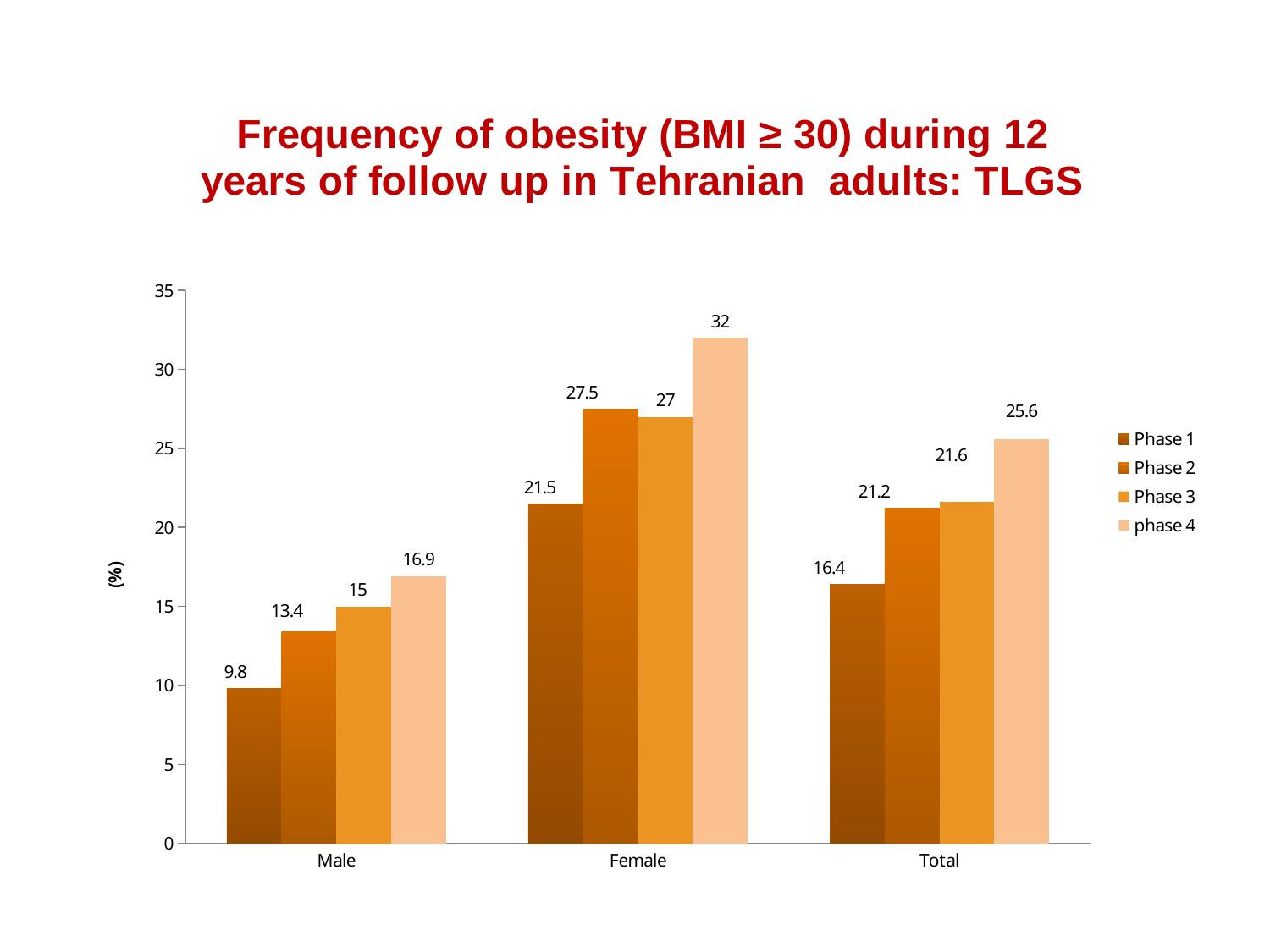
What is the value for Male in Phase 1? 9.8 What kind of chart is shown on the slide? Bar chart Which category has the highest phase 4 value? Female Which is larger for Female: Phase 2 or Phase 3? Phase 2 What is the value for Total in Phase 3? 21.6 What is the value for Female in phase 4? 32 What is the label on the y axis? (%) Do the Total values rise or fall from Phase 1 to phase 4? Rise How many series does the legend list? 4 What is the difference between the Female and Male values in phase 4? 15.1 How many categories are shown on the x axis? 3 Which category has the lowest Phase 1 value? Male